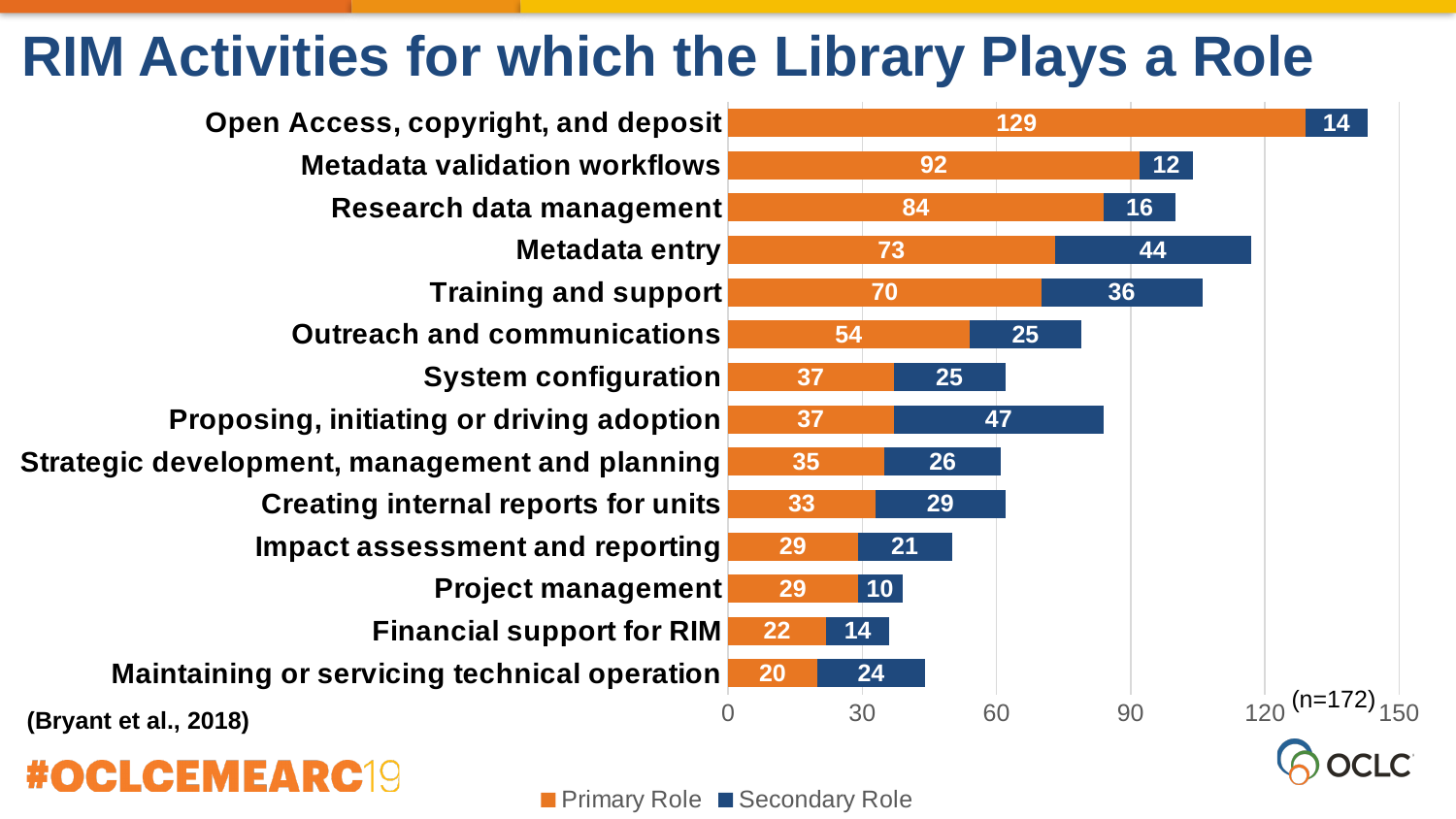
What is the Primary Role value for Open Access, copyright, and deposit? 129 Which activity has the lowest Primary Role value? Maintaining or servicing technical operation What is the total of the stacked bar for Metadata entry? 117 Which activity has the highest Secondary Role value? Proposing, initiating or driving adoption How many series does the legend list? 2 How many activities are shown on the chart? 14 Which activity has the highest Primary Role value? Open Access, copyright, and deposit Which is larger: the Secondary Role value for Training and support or for Outreach and communications? Training and support What is the difference between the Primary Role values for Metadata validation workflows and Research data management? 8 What is the total of the stacked bar for Financial support for RIM? 36 What is the Secondary Role value for Metadata entry? 44 What kind of chart is shown on the slide? Stacked bar chart